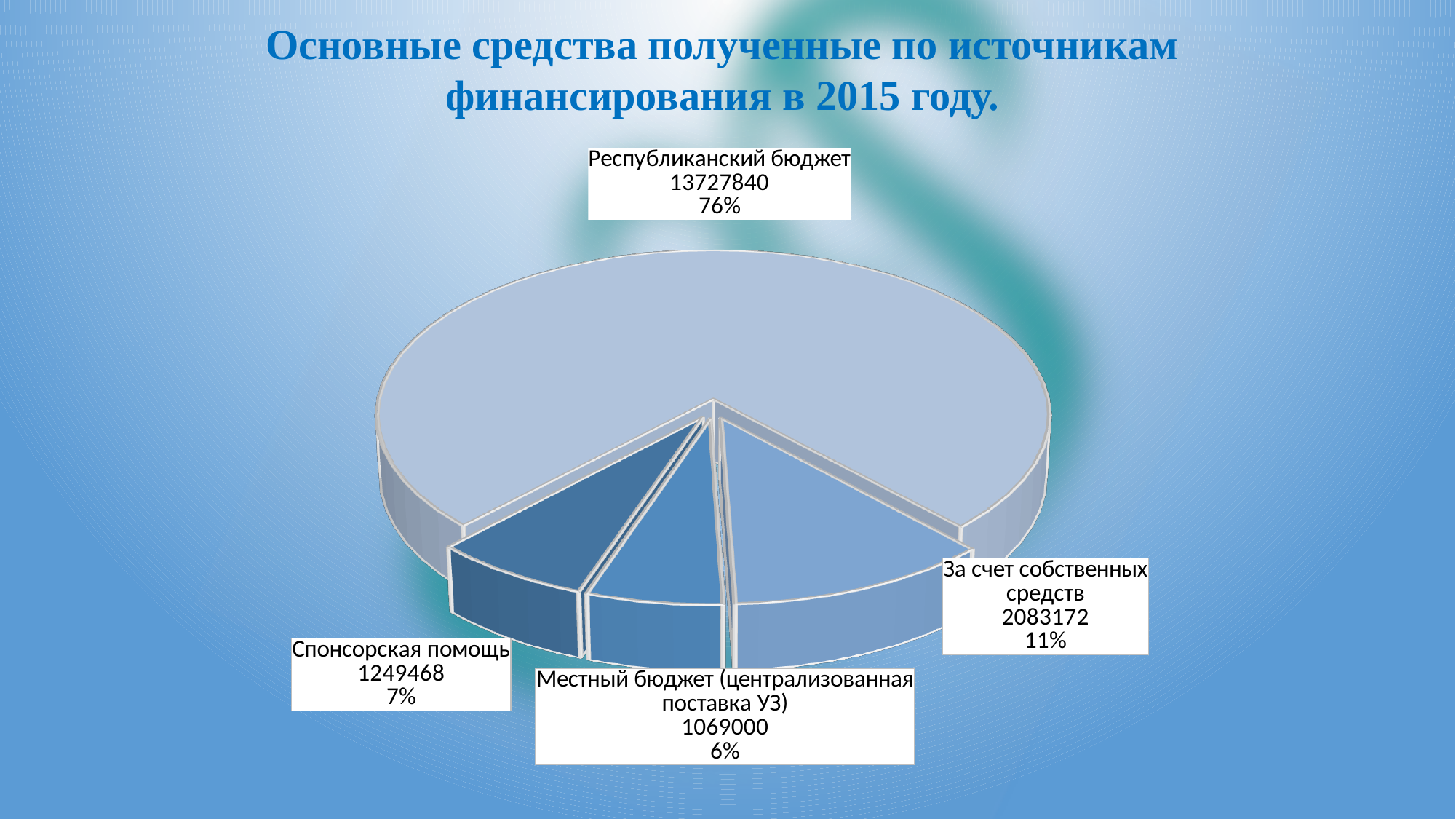
Which is larger: За счет собственных средств or Спонсорская помощь? За счет собственных средств Which source of funding has the largest slice? Республиканский бюджет What share of the pie does Республиканский бюджет represent? 76% How many slices does the pie chart have? 4 What share of the pie does Местный бюджет (централизованная поставка УЗ) represent? 6% What is the value for Республиканский бюджет? 13727840 What is the value for За счет собственных средств? 2083172 What type of chart is shown on the slide? pie chart What is the value for Местный бюджет (централизованная поставка УЗ)? 1069000 What is the value for Спонсорская помощь? 1249468 Which source of funding has the smallest slice? Местный бюджет (централизованная поставка УЗ) What is the difference between the values for Спонсорская помощь and Местный бюджет (централизованная поставка УЗ)? 180468